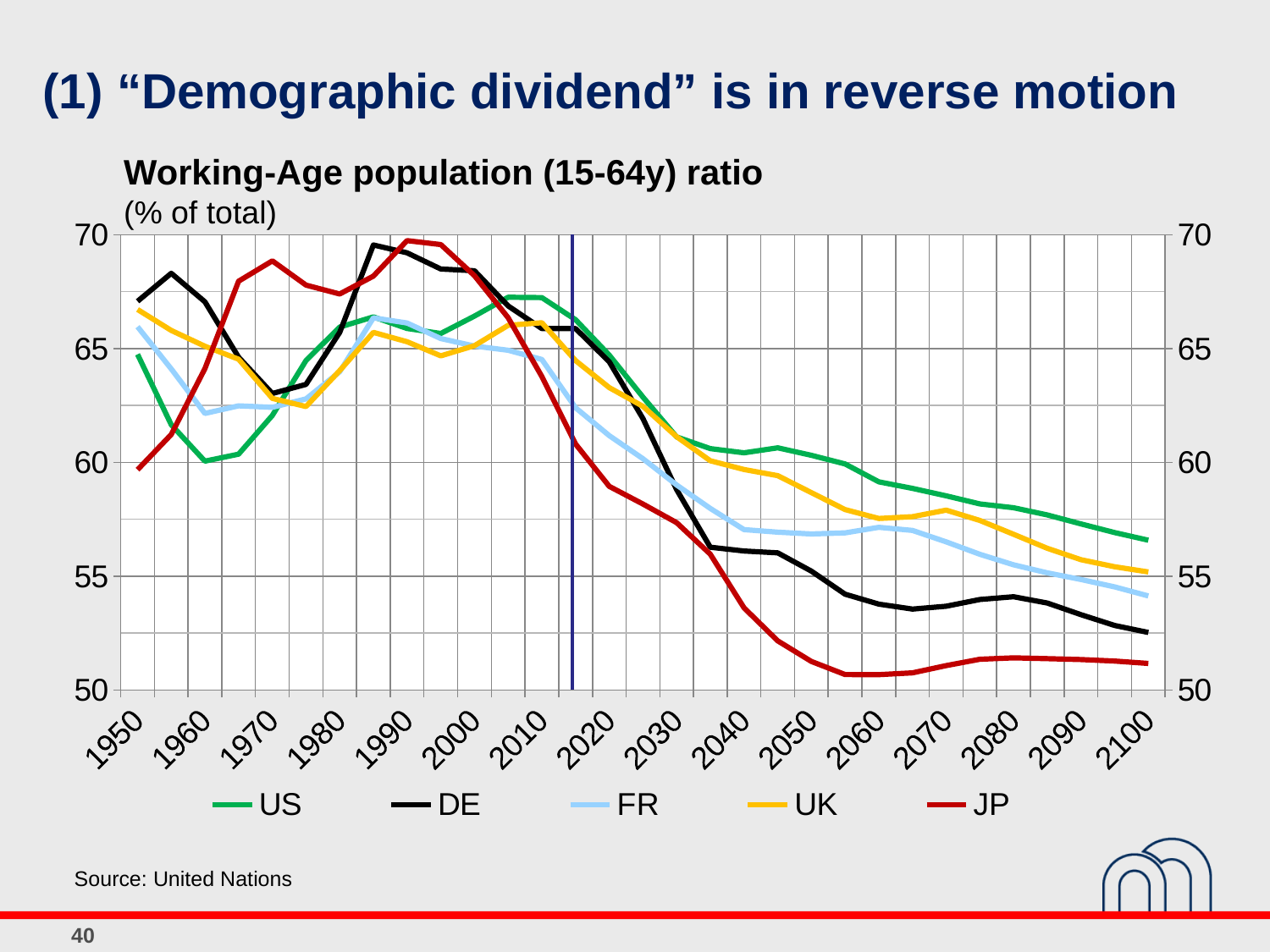
In 2050, which is larger, the value for DE or the value for JP? DE Is the value for US in 2100 greater or less than 55? greater Which series has the lowest value in 1950? JP How many series does the legend list? 5 Is the value for DE in 1950 greater or less than 65? greater Which series has the highest working-age population ratio in 2100? US Is the value for JP in 2100 greater or less than 55? less What is the title of the chart? Working-Age population (15-64y) ratio What kind of chart is shown on the slide? line chart Which series has the lowest working-age population ratio in 2100? JP Does the JP line rise or fall between 2000 and 2100? fall Which series has the highest value in 1950? DE